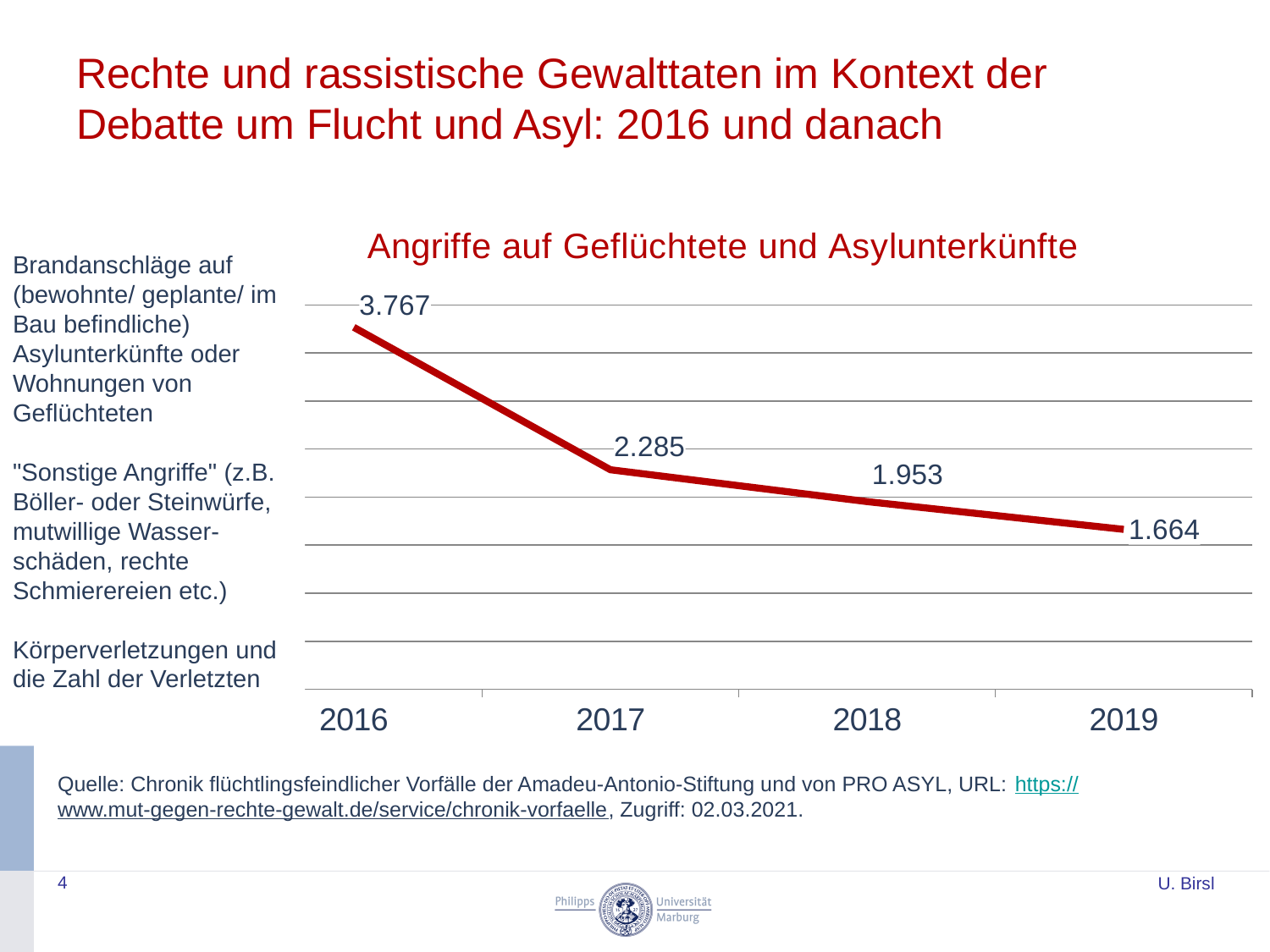
What kind of chart is shown? Line chart What is the value for 2016 in the chart 'Angriffe auf Geflüchtete und Asylunterkünfte'? 3.767 Which year has the highest value? 2016 What is the difference between the values for 2018 and 2019? 289 What is the value for 2017? 2.285 What is the value for 2019? 1.664 How many years are plotted on the x axis? 4 What is the difference between the values for 2016 and 2017? 1.482 Do the values rise or fall from 2016 to 2019? Fall What is the value for 2018? 1.953 Which is larger, the value for 2017 or the value for 2018? 2017 Which year has the lowest value? 2019